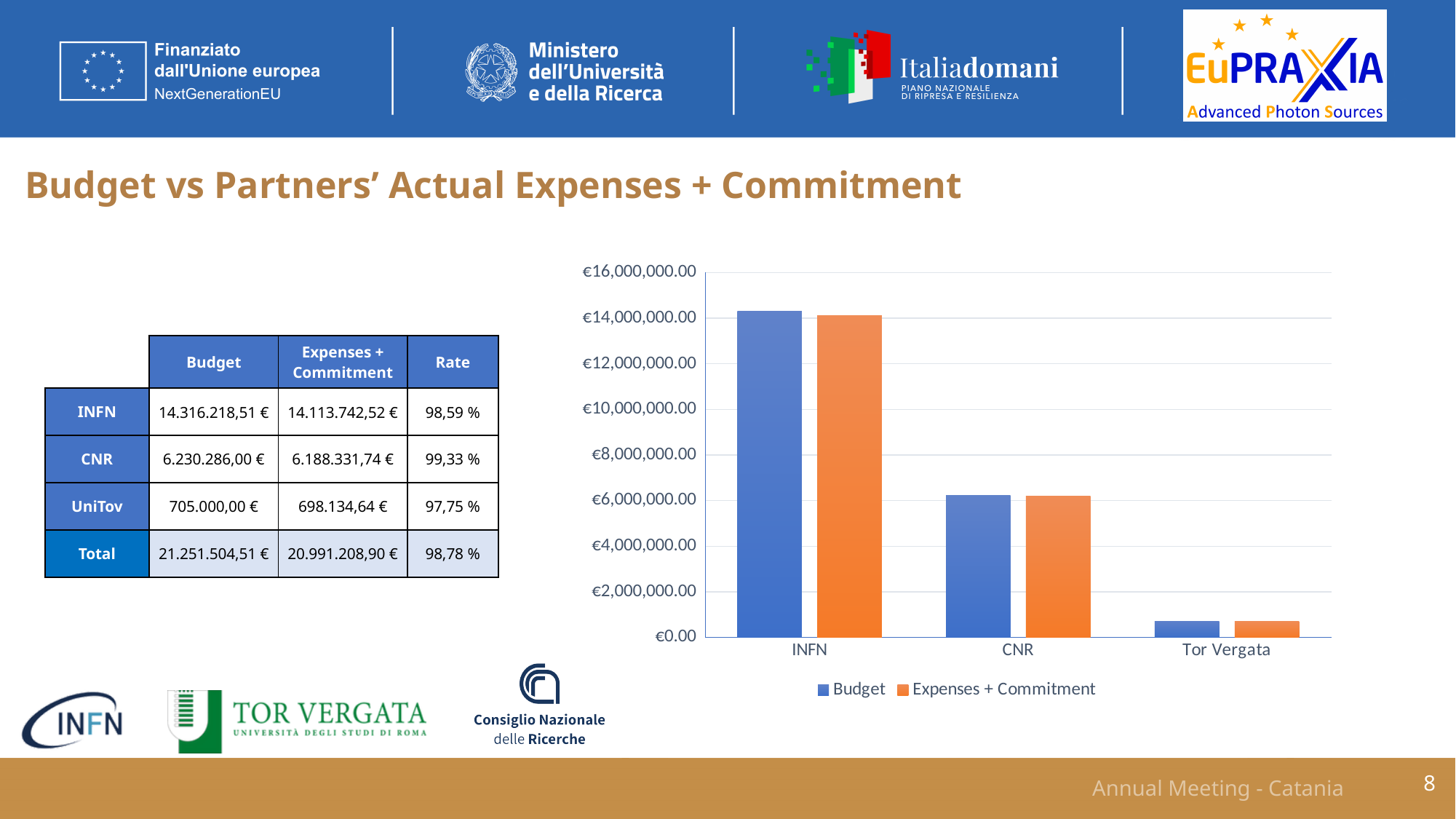
What is the title of the slide containing the chart? Budget vs Partners' Actual Expenses + Commitment What kind of chart is shown on the slide? bar chart Which partner has the highest Budget bar in the chart? INFN How many series does the chart legend list? 2 Is the Budget value for CNR greater or less than €8,000,000.00? less Is the Budget value for INFN greater or less than €12,000,000.00? greater Which is larger in the chart: the Budget for INFN or the Budget for CNR? Budget for INFN Which partner has the lowest Expenses + Commitment bar in the chart? Tor Vergata What colour are the Expenses + Commitment bars in the chart? orange Is the Expenses + Commitment value for Tor Vergata greater or less than €2,000,000.00? less Do the Budget bars rise or fall moving from INFN to Tor Vergata along the x axis? fall How many partner categories are shown on the x axis of the chart? 3